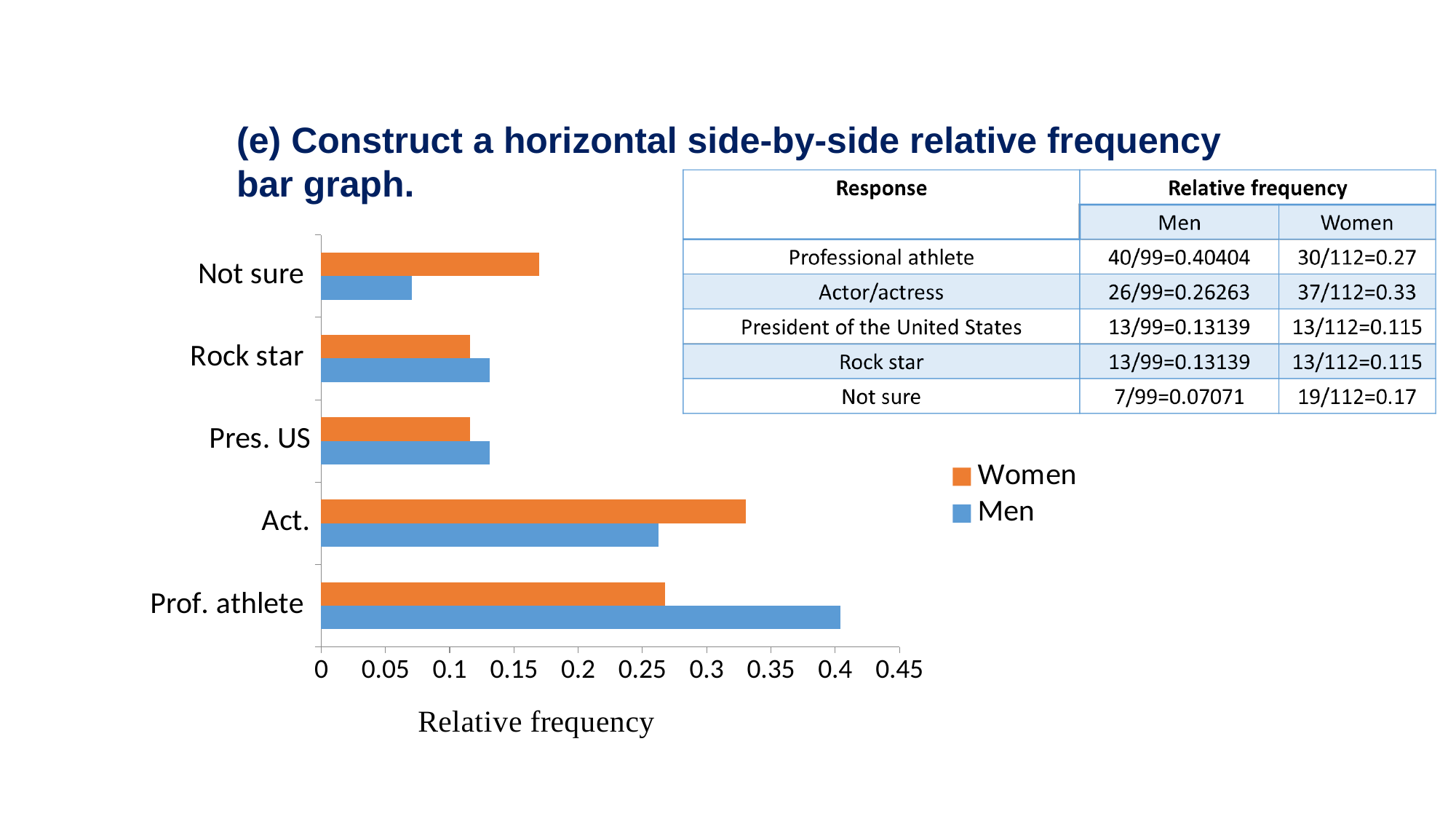
Which category has the longest Women bar? Act. For Prof. athlete, which series has the larger relative frequency, Men or Women? Men Which category has the longest Men bar? Prof. athlete Which category has the shortest Men bar? Not sure How many categories are shown on the chart's vertical axis? 5 What is the title of the chart's horizontal axis? Relative frequency For Act., which series has the larger relative frequency, Men or Women? Women How many series does the chart's legend list? 2 Is the Men value for Prof. athlete greater or less than 0.35? greater Is the Men value for Not sure greater or less than 0.1? less What kind of chart is shown on the slide? bar chart For Not sure, which series has the larger relative frequency, Men or Women? Women